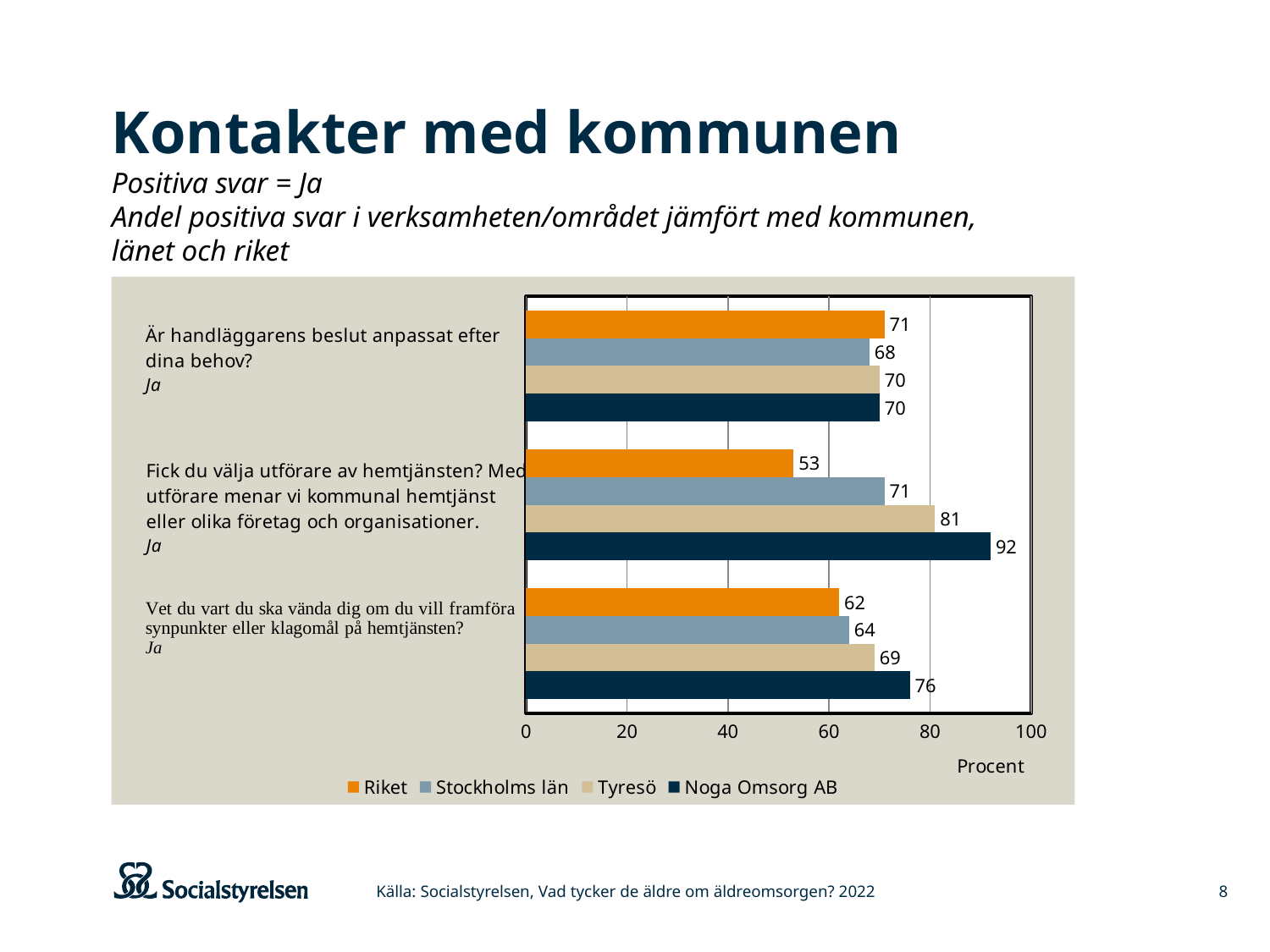
What is the value for Noga Omsorg AB on the question "Fick du välja utförare av hemtjänsten?"? 92 How many questions (categories) are shown in the chart? 3 Which is larger on the question "Vet du vart du ska vända dig om du vill framföra synpunkter eller klagomål på hemtjänsten?": Noga Omsorg AB or Stockholms län? Noga Omsorg AB What kind of chart is shown on the slide? Bar chart How many series does the legend list? 4 What is the value for Stockholms län on the question "Fick du välja utförare av hemtjänsten?"? 71 Which series has the highest value on the question "Fick du välja utförare av hemtjänsten?"? Noga Omsorg AB Which series has the lowest value on the question "Vet du vart du ska vända dig om du vill framföra synpunkter eller klagomål på hemtjänsten?"? Riket What is the difference between Noga Omsorg AB and Riket on the question "Fick du välja utförare av hemtjänsten?"? 39 What is the value for Riket on the question "Är handläggarens beslut anpassat efter dina behov?"? 71 Is the value for Riket on the question "Fick du välja utförare av hemtjänsten?" greater or less than 60? less What is the value for Tyresö on the question "Vet du vart du ska vända dig om du vill framföra synpunkter eller klagomål på hemtjänsten?"? 69